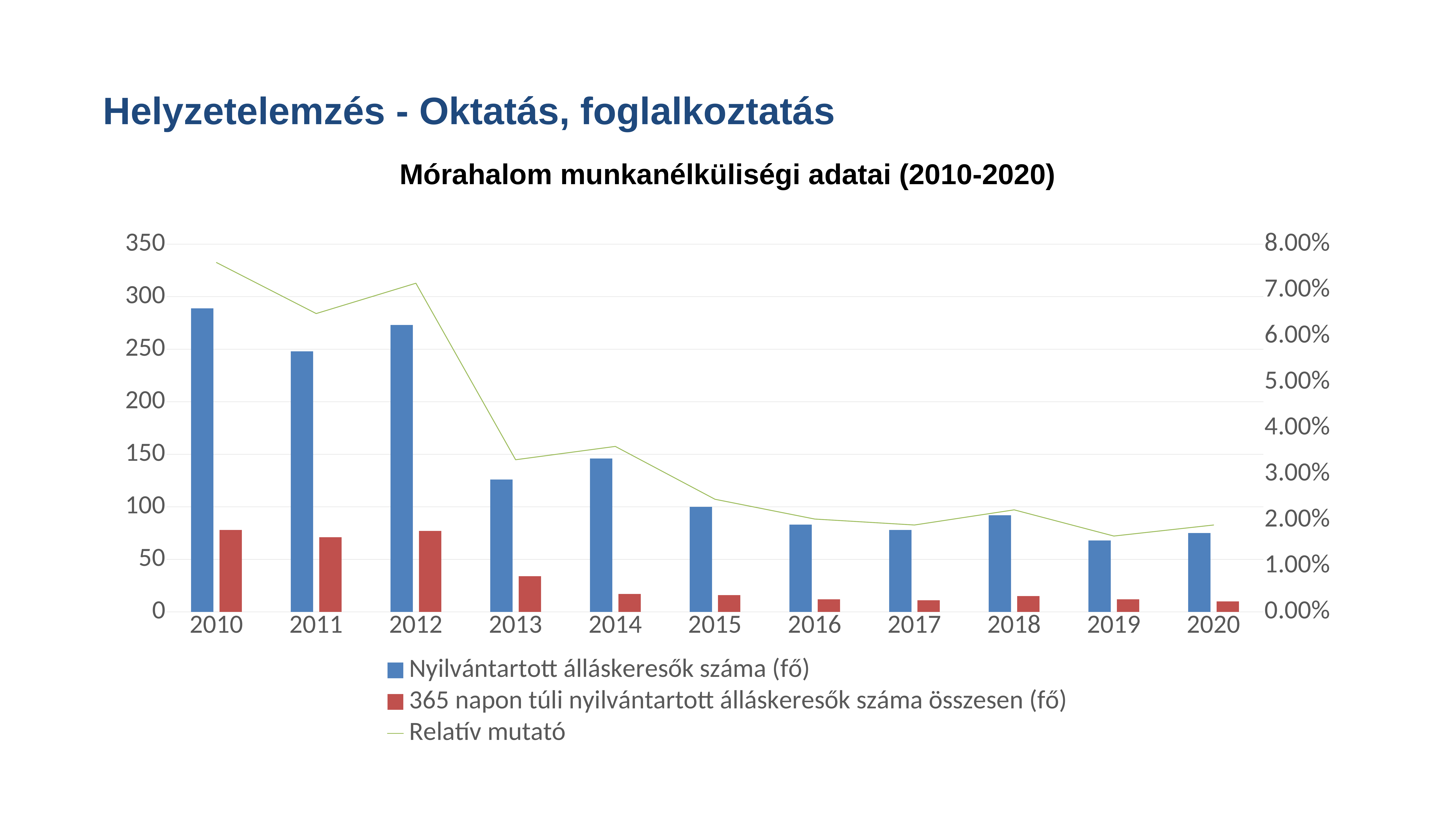
How many years are shown on the x axis? 11 Is the Relatív mutató value in 2011 greater or less than 6.00%? greater What is the title of the chart? Mórahalom munkanélküliségi adatai (2010-2020) Which year has the larger value for Nyilvántartott álláskeresők száma (fő), 2011 or 2012? 2012 Is the value for Nyilvántartott álláskeresők száma (fő) in 2010 greater or less than 250? greater Does the Relatív mutató line generally rise or fall from 2010 to 2020? fall How many series does the legend list? 3 What kind of chart is this? Combined bar and line chart Is the value for Nyilvántartott álláskeresők száma (fő) in 2013 greater or less than 150? less In which year is the value for Nyilvántartott álláskeresők száma (fő) highest? 2010 In which year does the Relatív mutató line reach its highest point? 2010 In which year is the value for Nyilvántartott álláskeresők száma (fő) lowest? 2019